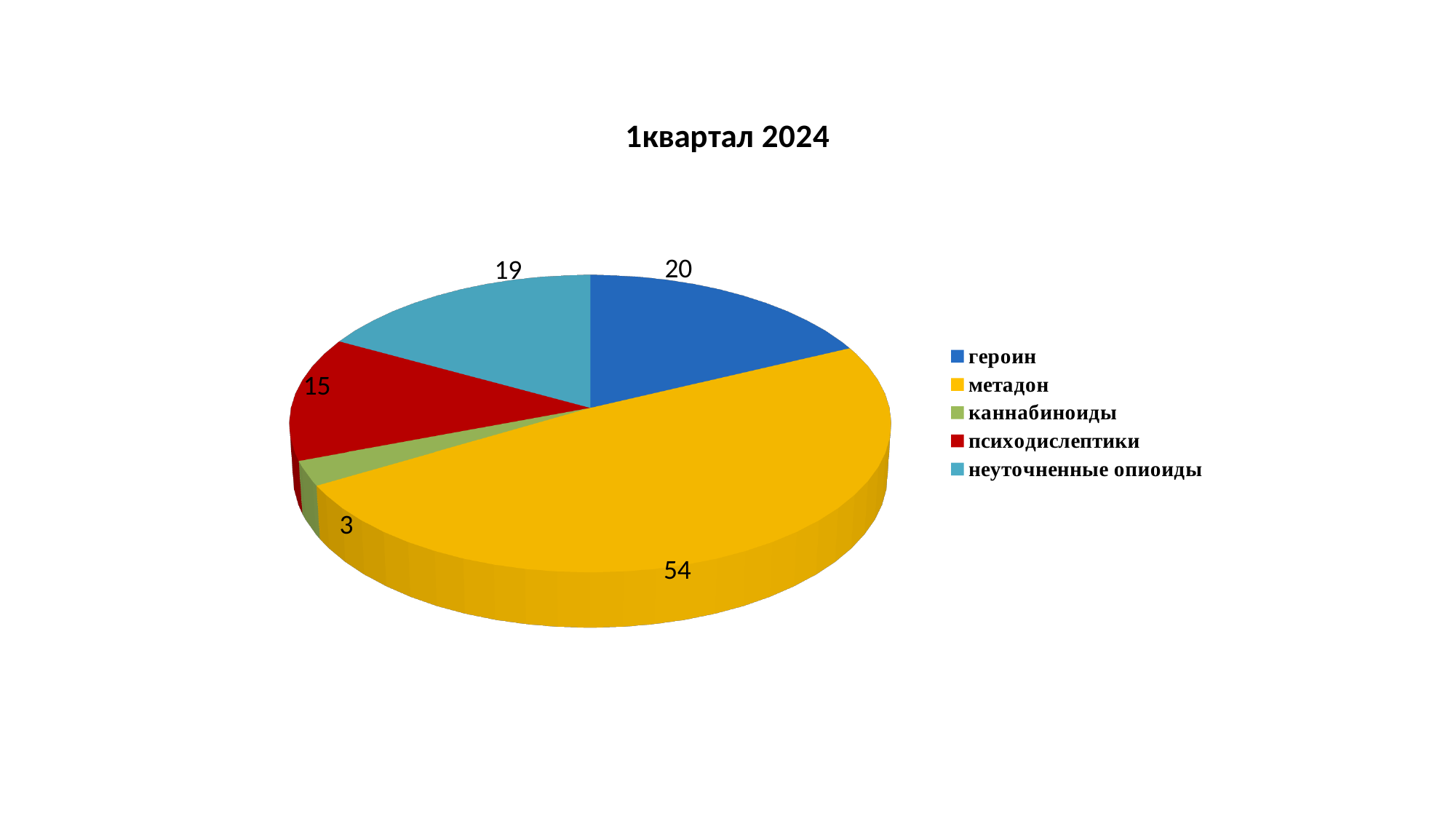
Which is larger, the value for психодислептики or the value for неуточненные опиоиды? неуточненные опиоиды What is the title of the chart? 1квартал 2024 Which category has the smallest slice? каннабиноиды What is the value for психодислептики? 15 What is the value for метадон? 54 What is the value for каннабиноиды? 3 What is the value for неуточненные опиоиды? 19 How many categories does the pie chart show? 5 What is the value for героин? 20 Which category has the largest slice? метадон What kind of chart is shown on the slide? pie chart What is the difference between the values for метадон and героин? 34